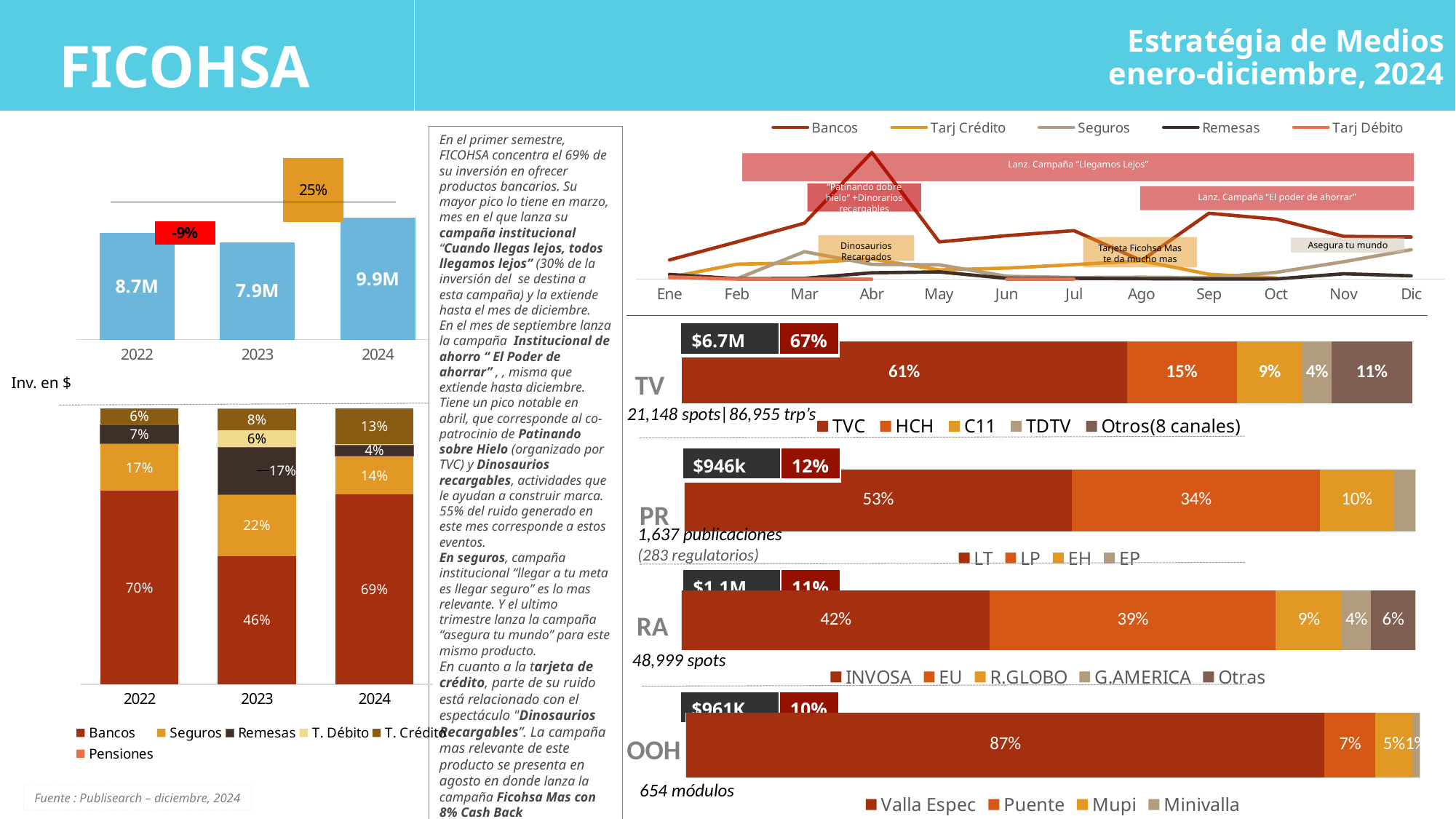
In the line chart at the top right, how many months are plotted along the x axis? 12 In the stacked bar chart at the bottom left, how many series does the legend list? 6 In the stacked bar chart at the bottom left, what is the difference between the Bancos share in 2022 and in 2023? 24 percentage points In the line chart at the top right, in which month does the Bancos line reach its highest point? Abr In the 'Inv. en $' bar chart on the left, what is the percentage change label shown above the 2023 bar? -9% In the PR bar on the right, which is larger, LT or LP? LT In the 'Inv. en $' bar chart on the left, what is the value for 2024? 9.9M In the stacked bar chart at the bottom left, what share does Bancos have in 2023? 46% In the TV bar on the right, what share does TVC have? 61% In the OOH bar on the right, what is the total investment amount shown in the dark label? $961K In the 'Inv. en $' bar chart on the left, which year has the lowest investment? 2023 In the RA bar on the right, what share does EU have? 39%